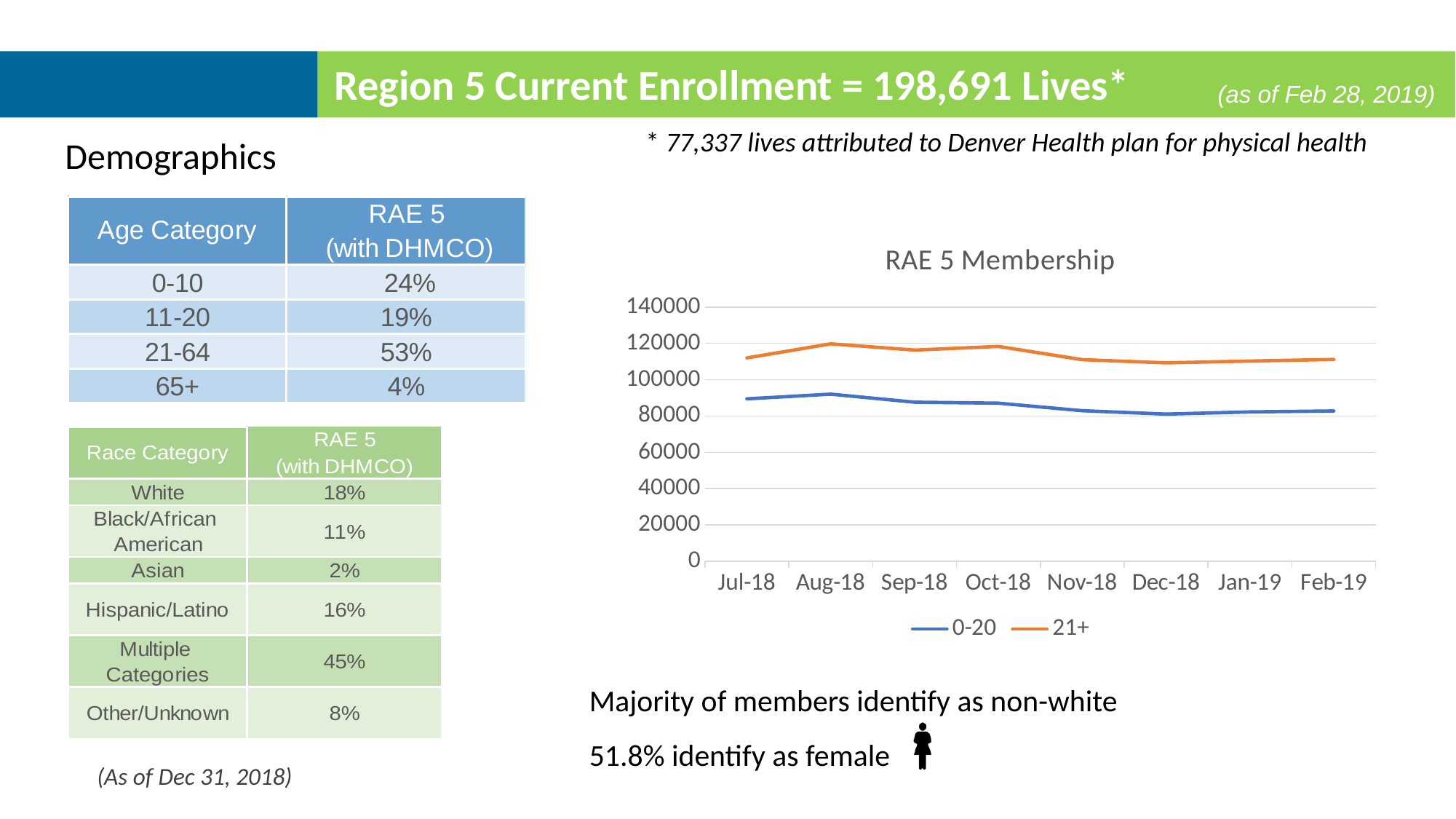
In the RAE 5 Membership chart, is the value for 21+ in Nov-18 greater or less than 120000? less What kind of chart is the RAE 5 Membership chart? line chart In the RAE 5 Membership chart, is the value for 21+ in Aug-18 greater or less than 100000? greater In the RAE 5 Membership chart, is the value for 0-20 in Jul-18 greater or less than 100000? less How many months are plotted along the x axis of the RAE 5 Membership chart? 8 How many series does the legend of the RAE 5 Membership chart list? 2 In the RAE 5 Membership chart, does the 0-20 series rise or fall overall from Jul-18 to Feb-19? fall In the RAE 5 Membership chart, in which month does the 0-20 series reach its highest value? Aug-18 What is the title of the line chart on the slide? RAE 5 Membership In the RAE 5 Membership chart, which series is higher in Feb-19, 0-20 or 21+? 21+ In the RAE 5 Membership chart, which series is drawn in orange? 21+